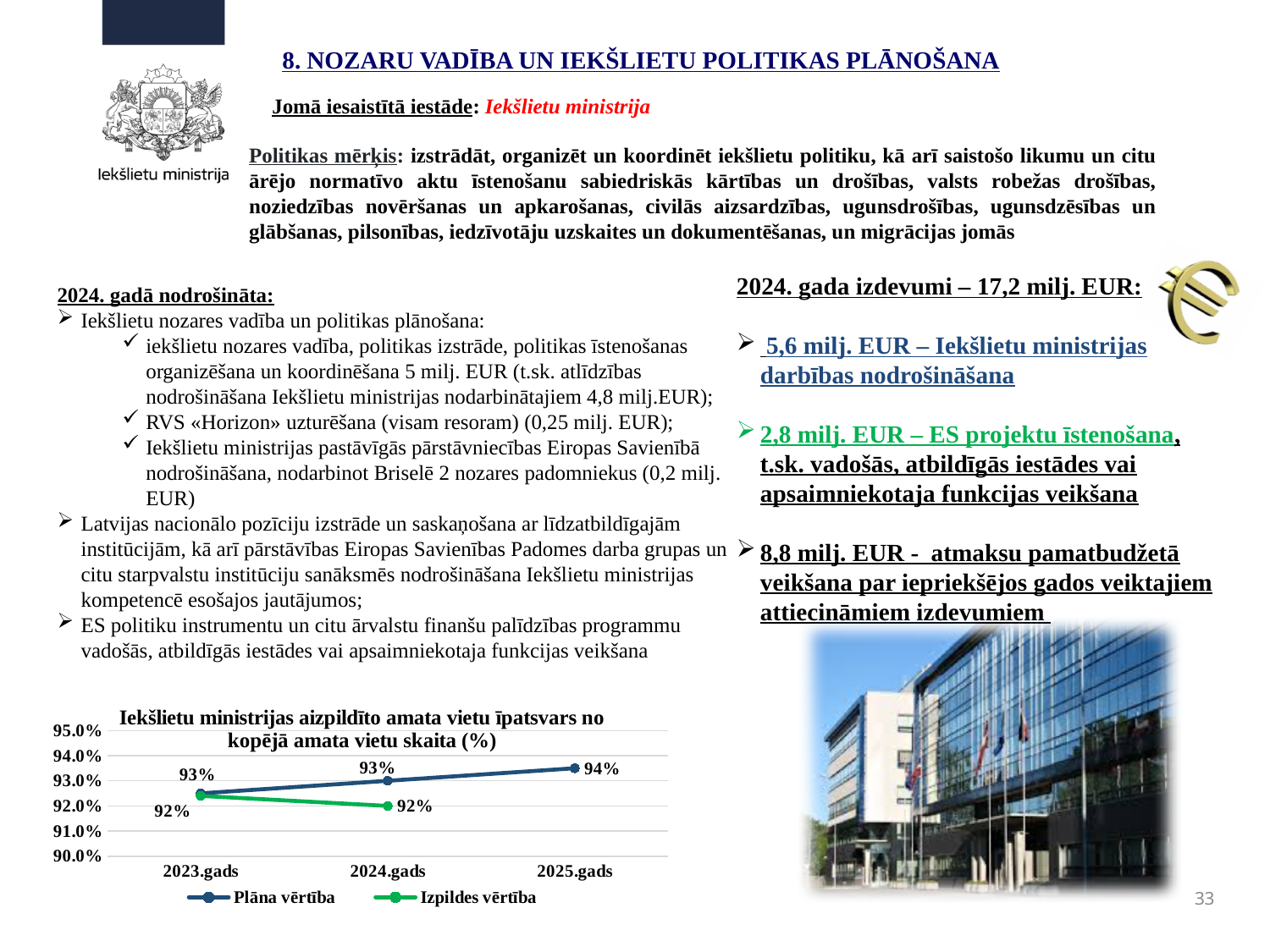
What is the Plāna vērtība for 2024.gads? 93% How many series does the chart legend list? 2 How many years are shown on the x axis of the chart? 3 What is the difference between Plāna vērtība and Izpildes vērtība in 2024.gads? 1 percentage point What kind of chart is shown on the slide? line chart What is the Plāna vērtība for 2025.gads? 94% Does the Plāna vērtība line rise or fall from 2023.gads to 2025.gads? rise Is the Izpildes vērtība for 2024.gads greater or less than 93.0%? less What is the Izpildes vērtība for 2024.gads? 92% In 2024.gads, which is larger: Plāna vērtība or Izpildes vērtība? Plāna vērtība Which two series are listed in the chart legend? Plāna vērtība and Izpildes vērtība What is the title of the chart on the slide? Iekšlietu ministrijas aizpildīto amata vietu īpatsvars no kopējā amata vietu skaita (%)